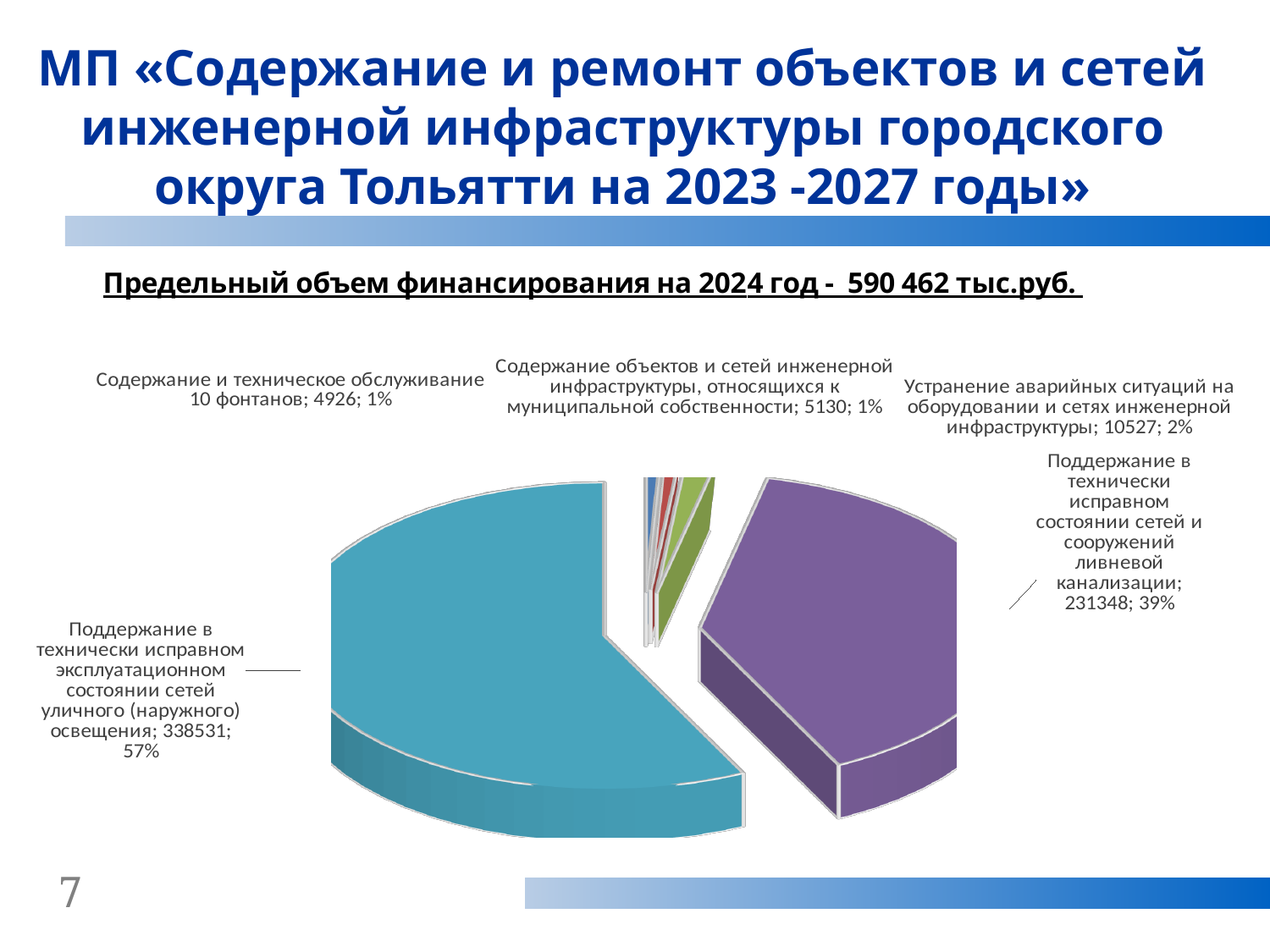
What share of the pie does «Содержание объектов и сетей инженерной инфраструктуры, относящихся к муниципальной собственности» take? 1% What value is shown for «Поддержание в технически исправном состоянии сетей и сооружений ливневой канализации»? 231348 What value is shown for «Устранение аварийных ситуаций на оборудовании и сетях инженерной инфраструктуры»? 10527 What value is shown for «Поддержание в технически исправном эксплуатационном состоянии сетей уличного (наружного) освещения»? 338531 What kind of chart is shown on the slide? pie chart Which category has the smallest value in the pie chart? Содержание и техническое обслуживание 10 фонтанов What value is shown for «Содержание и техническое обслуживание 10 фонтанов»? 4926 What is the difference between the values for «Поддержание в технически исправном эксплуатационном состоянии сетей уличного (наружного) освещения» and «Поддержание в технически исправном состоянии сетей и сооружений ливневой канализации»? 107183 What share of the pie does «Поддержание в технически исправном состоянии сетей и сооружений ливневой канализации» take? 39% Which category has the largest slice of the pie? Поддержание в технически исправном эксплуатационном состоянии сетей уличного (наружного) освещения How many slices does the pie chart have? 5 Which is larger: the value for «Устранение аварийных ситуаций на оборудовании и сетях инженерной инфраструктуры» or for «Содержание объектов и сетей инженерной инфраструктуры, относящихся к муниципальной собственности»? Устранение аварийных ситуаций на оборудовании и сетях инженерной инфраструктуры